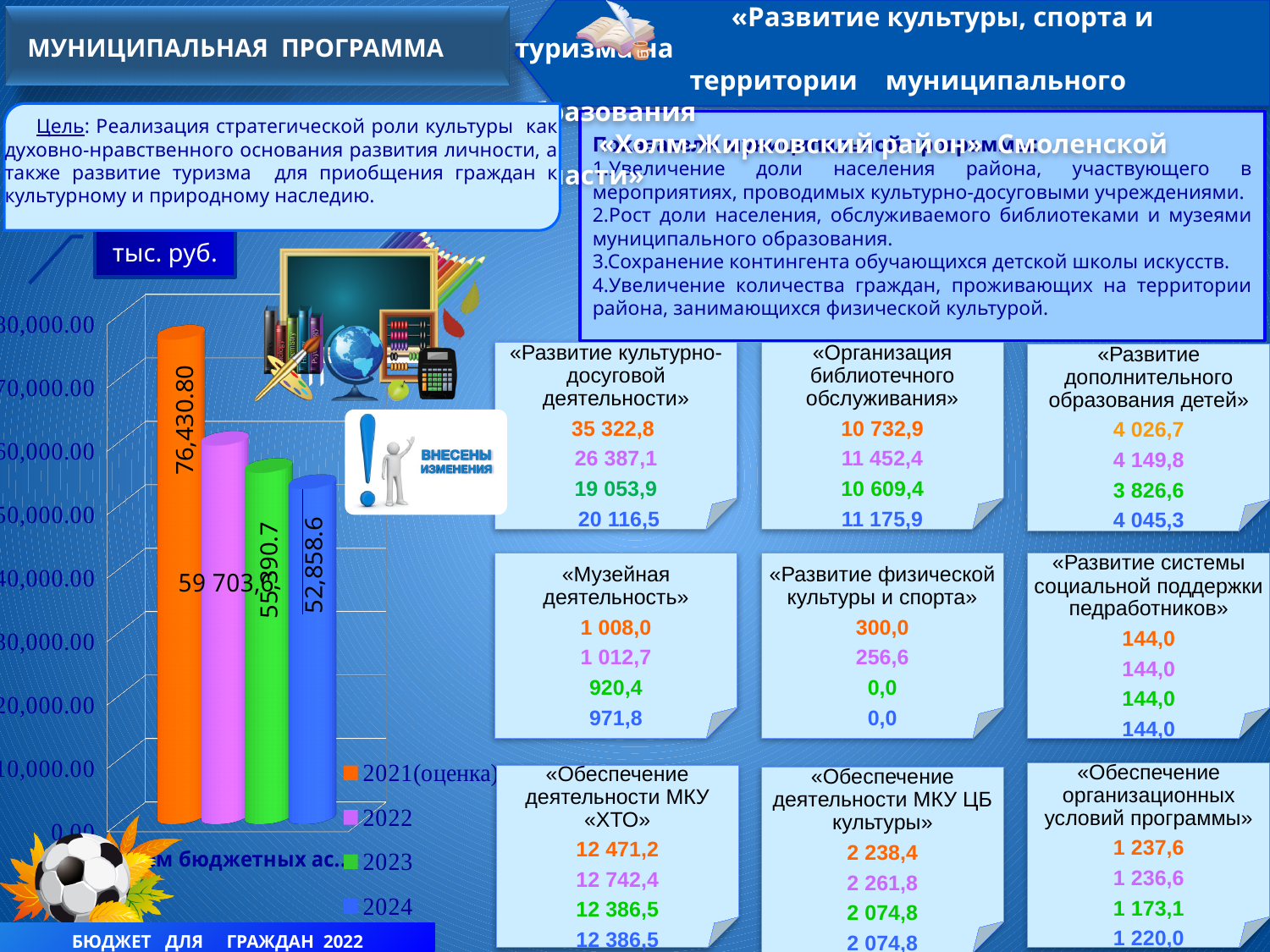
What unit is indicated for the chart values? тыс. руб. Which year has the highest value in the chart? 2021(оценка) What is the value of the 2021(оценка) bar? 76,430.80 Which is larger, the value for 2023 or the value for 2024? 2023 Do the values rise or fall from 2021(оценка) to 2024? fall Which year has the lowest value in the chart? 2024 How many entries does the chart legend list? 4 What type of chart is shown on the slide? bar chart What is the value of the 2023 bar? 55,390.7 What is the value of the 2024 bar? 52,858.6 How many bars are plotted in the chart? 4 Is the value for 2022 greater or less than 50,000.00? greater